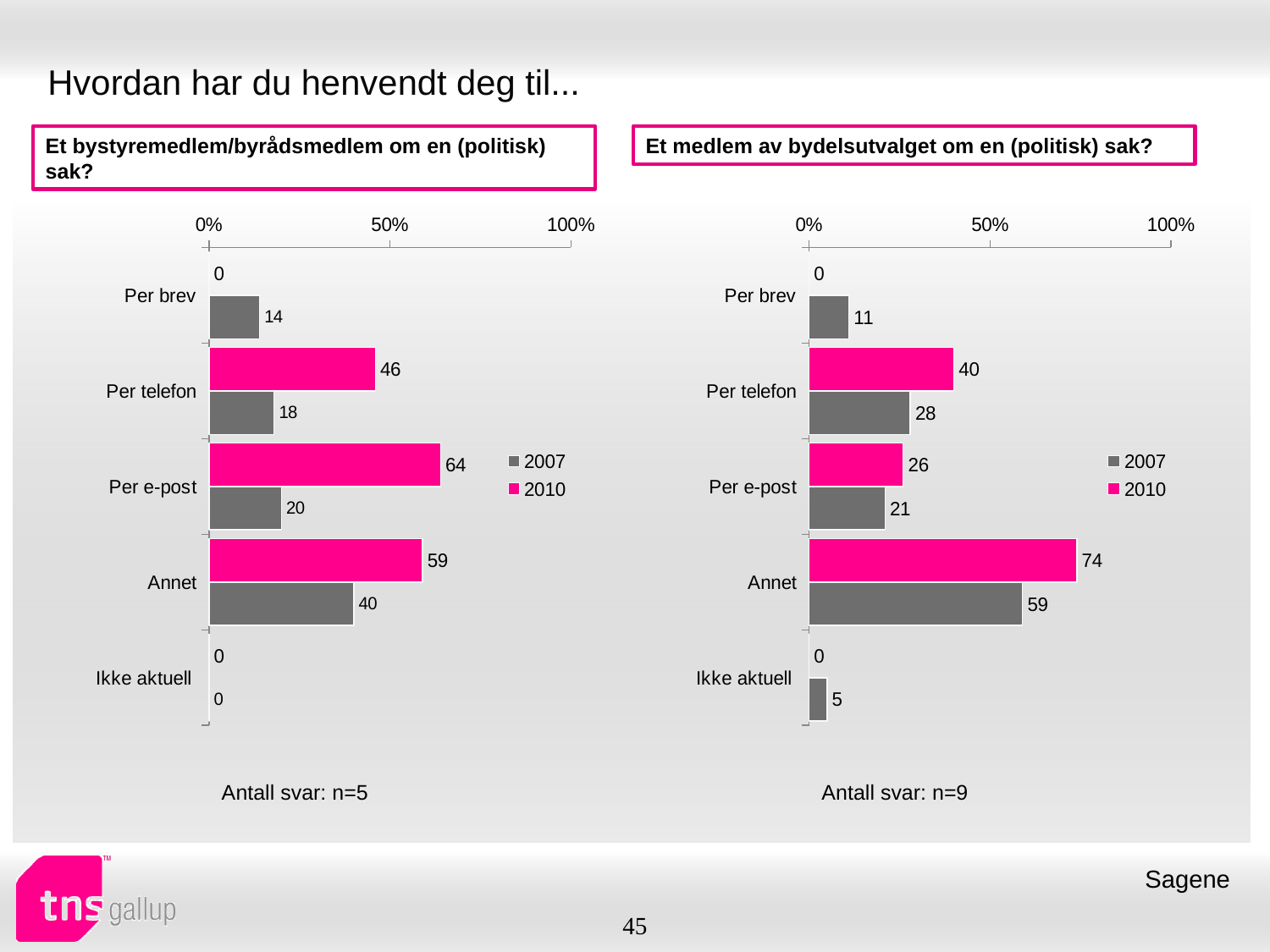
In the right chart (Et medlem av bydelsutvalget om en (politisk) sak?), what is the difference between the 2010 and 2007 values for Annet? 15 In the right chart (Et medlem av bydelsutvalget om en (politisk) sak?), what is the 2010 value for Annet? 74 In the left chart (Et bystyremedlem/byrådsmedlem om en (politisk) sak?), what is the difference between the 2010 and 2007 values for Per telefon? 28 In the left chart (Et bystyremedlem/byrådsmedlem om en (politisk) sak?), which category has the highest 2010 value? Per e-post In the right chart (Et medlem av bydelsutvalget om en (politisk) sak?), which is larger: the 2010 value for Per telefon or the 2010 value for Per e-post? Per telefon How many categories are shown in the left chart (Et bystyremedlem/byrådsmedlem om en (politisk) sak?)? 5 In the right chart (Et medlem av bydelsutvalget om en (politisk) sak?), what is the 2007 value for Per telefon? 28 How many series does the legend of the right chart (Et medlem av bydelsutvalget om en (politisk) sak?) list? 2 In the left chart (Et bystyremedlem/byrådsmedlem om en (politisk) sak?), what is the 2007 value for Annet? 40 What kind of chart is the left chart (Et bystyremedlem/byrådsmedlem om en (politisk) sak?)? Bar chart In the left chart (Et bystyremedlem/byrådsmedlem om en (politisk) sak?), what is the 2010 value for Per e-post? 64 In the right chart (Et medlem av bydelsutvalget om en (politisk) sak?), which category has the highest 2007 value? Annet